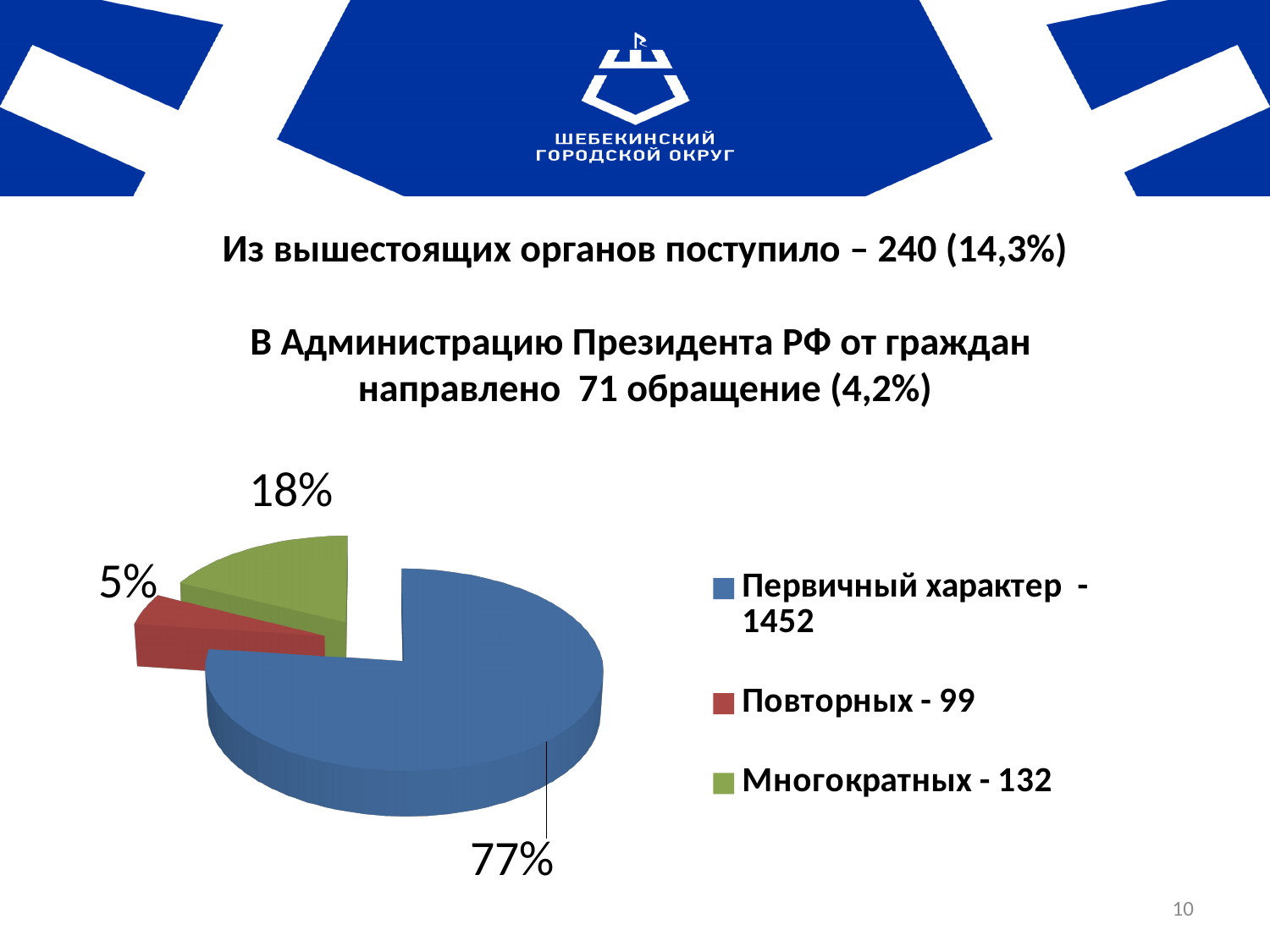
How many entries does the legend of the pie chart list? 3 How many slices does the pie chart have? 3 What kind of chart is shown on the slide? Pie chart What percentage share does the slice for "Первичный характер" have in the pie chart? 77% What colour is the slice for "Многократных" in the pie chart? Green What number is shown in the legend next to "Повторных"? 99 Which slice is larger: "Многократных" or "Повторных"? Многократных What is the difference in percentage points between the "Многократных" slice and the "Повторных" slice? 13 What percentage share does the slice for "Многократных" have in the pie chart? 18% Which category has the smallest slice in the pie chart? Повторных Which category has the largest slice in the pie chart? Первичный характер What percentage share does the slice for "Повторных" have in the pie chart? 5%